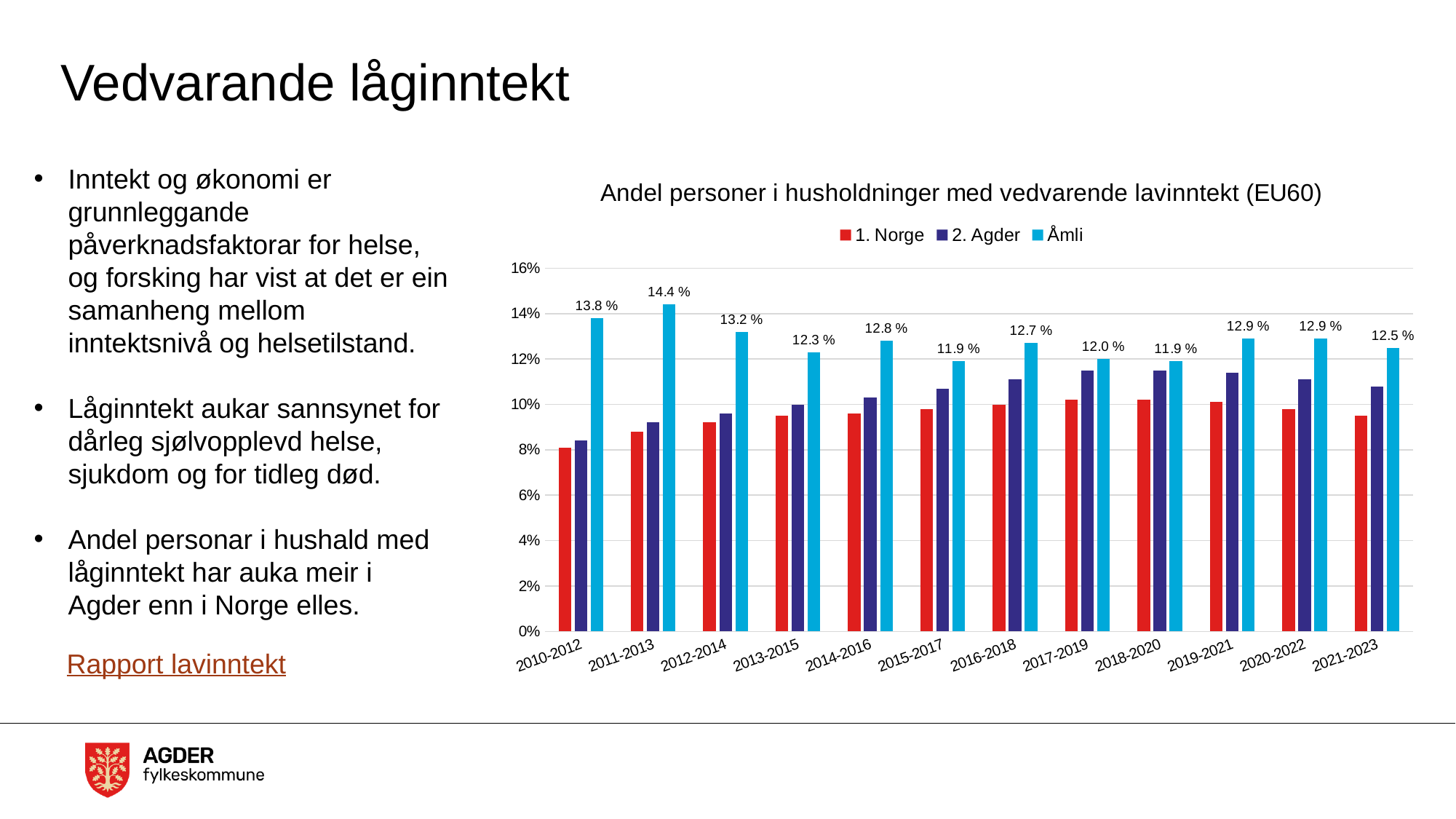
What is the title of the chart? Andel personer i husholdninger med vedvarende lavinntekt (EU60) In which period is the Åmli value highest? 2011-2013 What is the value for Åmli in 2017-2019? 12.0 % What is the value for Åmli in 2011-2013? 14.4 % How many series does the chart legend list? 3 What is the value for Åmli in 2021-2023? 12.5 % What type of chart is shown on the slide? Bar chart Which is larger for Åmli: the value in 2012-2014 or the value in 2013-2015? 2012-2014 What is the lowest value shown for Åmli? 11.9 % What is the difference between the Åmli values for 2011-2013 and 2010-2012? 0.6 percentage points Is the value for 1. Norge in 2010-2012 greater or less than 10%? less How many time periods are shown on the x axis of the chart? 12